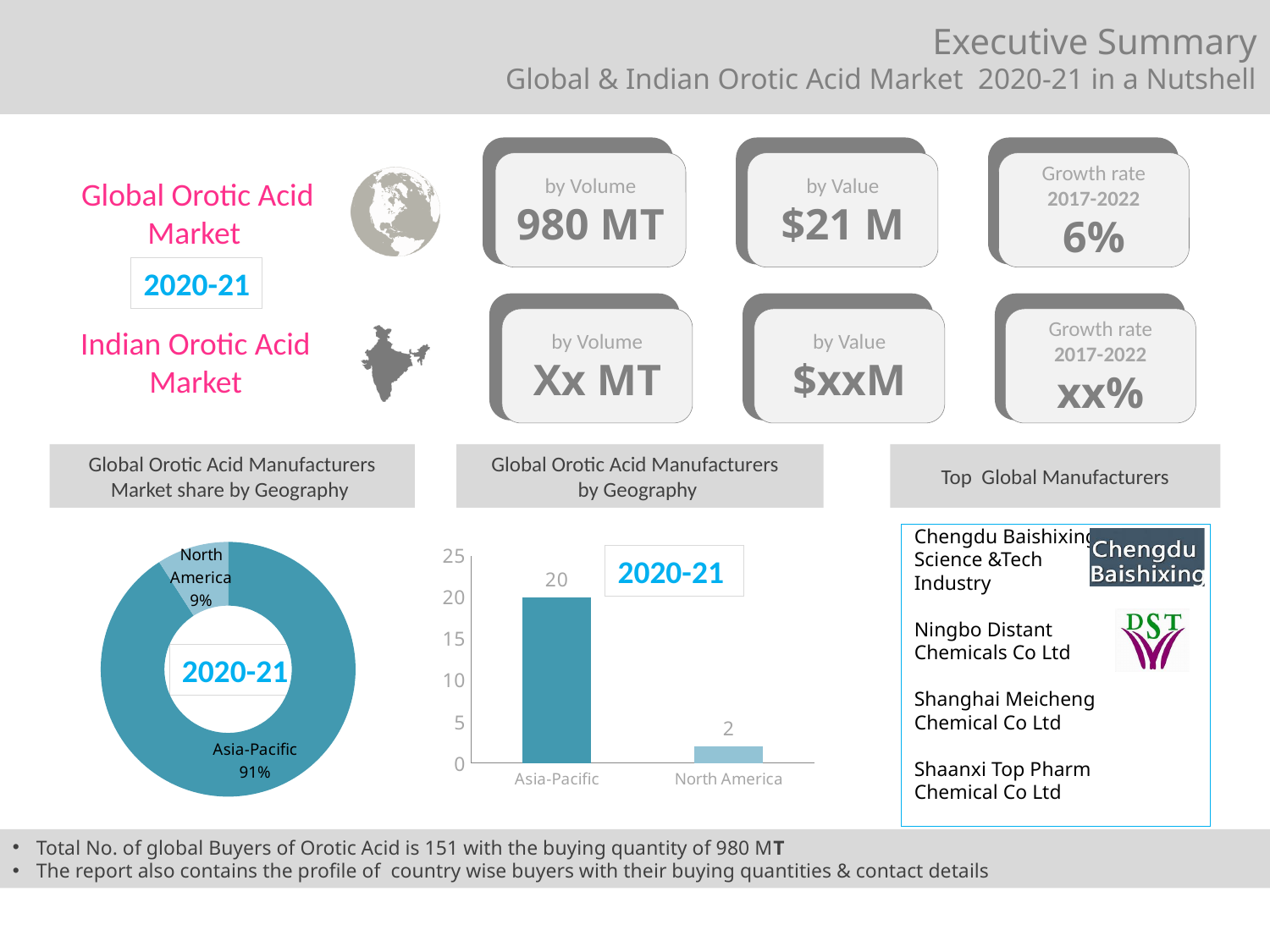
In the 'Global Orotic Acid Manufacturers by Geography' chart, what is the difference between Asia-Pacific and North America? 18 In the 'Global Orotic Acid Manufacturers Market share by Geography' chart, what share does Asia-Pacific hold? 91% In the 'Global Orotic Acid Manufacturers by Geography' chart, which region has the lowest value? North America What kind of chart is the 'Global Orotic Acid Manufacturers by Geography' chart? Bar chart What year label is shown inside the 'Global Orotic Acid Manufacturers Market share by Geography' doughnut chart? 2020-21 In the 'Global Orotic Acid Manufacturers by Geography' chart, what is the value for North America? 2 What kind of chart is the 'Global Orotic Acid Manufacturers Market share by Geography' chart? Pie chart (doughnut) In the 'Global Orotic Acid Manufacturers Market share by Geography' chart, which region has the largest share? Asia-Pacific In the 'Global Orotic Acid Manufacturers Market share by Geography' chart, what share does North America hold? 9% How many regions are shown in the 'Global Orotic Acid Manufacturers Market share by Geography' chart? 2 In the 'Global Orotic Acid Manufacturers by Geography' chart, is the value for Asia-Pacific greater or less than 15? greater In the 'Global Orotic Acid Manufacturers by Geography' chart, what is the value for Asia-Pacific? 20